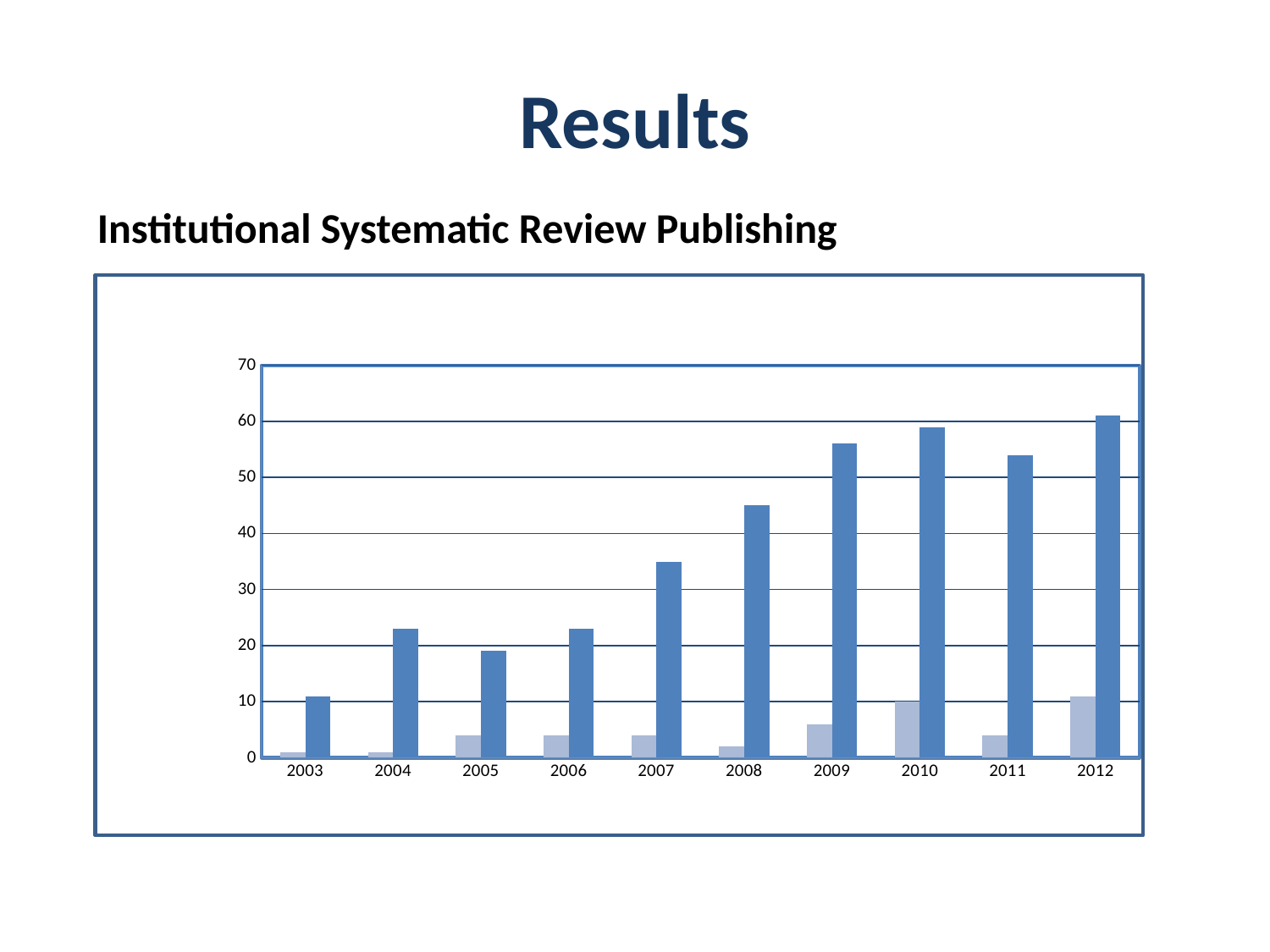
Which year has the larger light blue bar, 2003 or 2012? 2012 Which year has the larger dark blue bar, 2005 or 2008? 2008 Is the dark blue bar for 2008 greater or less than 40? greater Is the dark blue bar for 2009 greater or less than 50? greater Do the dark blue bars generally rise or fall from 2003 to 2012? rise Which year has the lowest dark blue bar? 2003 What kind of chart is shown on the slide? bar chart How many years are shown along the x axis of the chart? 10 Is the dark blue bar for 2007 greater or less than 40? less What is the highest value shown on the y axis of the chart? 70